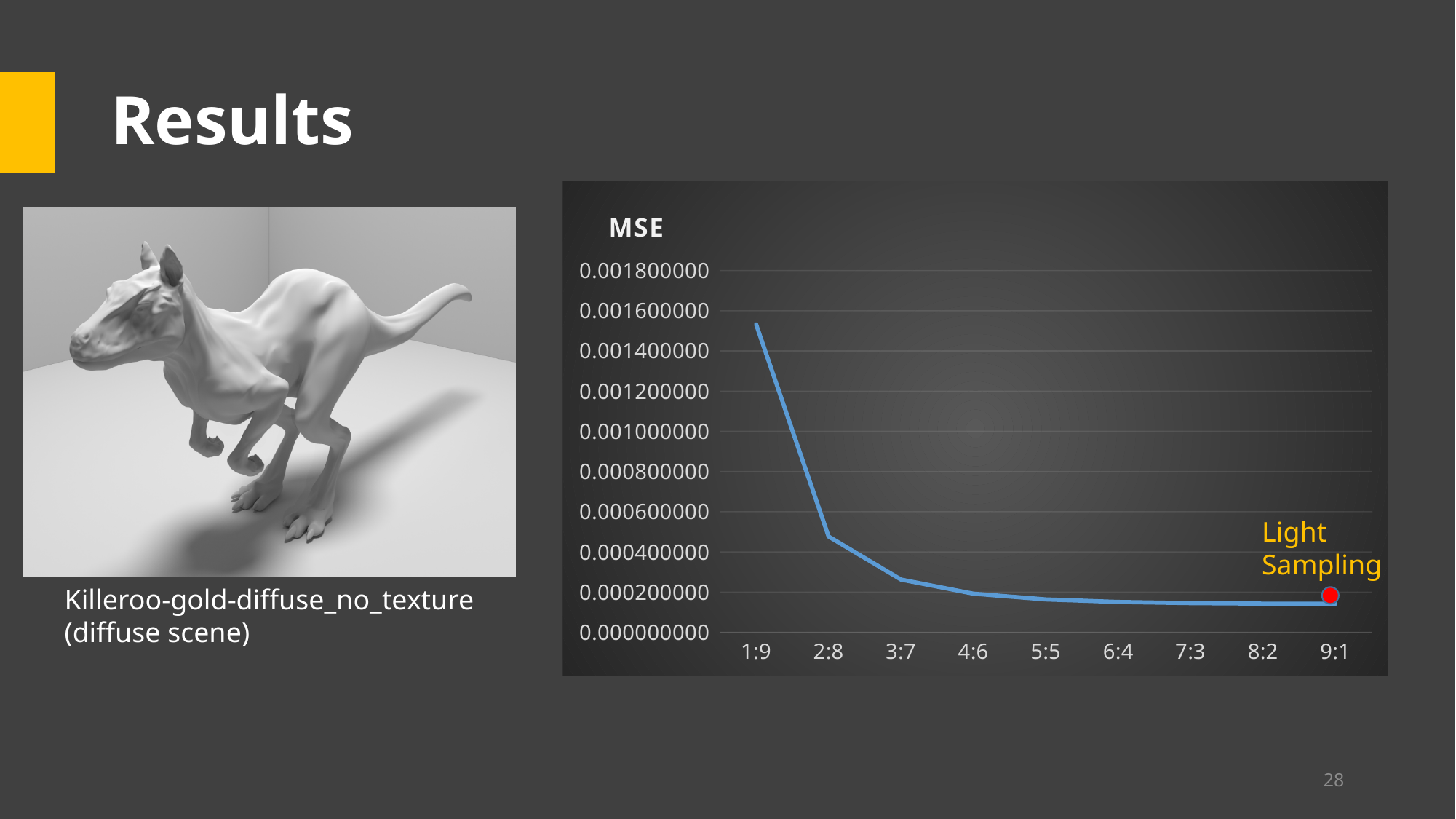
Which has the larger MSE value, 2:8 or 5:5? 2:8 What is the title of the chart? MSE How many points are plotted along the x axis of the MSE chart? 9 Is the MSE value for 1:9 greater or less than 0.001800000? less Which x-axis category has the highest MSE value? 1:9 Is the MSE value for 3:7 greater or less than 0.000400000? less Do the MSE values rise or fall as you move from 1:9 to 9:1 along the x axis? fall Which x-axis category is marked with the red dot labelled "Light Sampling"? 9:1 Is the MSE value for 2:8 greater or less than 0.000600000? less What kind of chart is shown on the slide? line chart Which has the larger MSE value, 1:9 or 2:8? 1:9